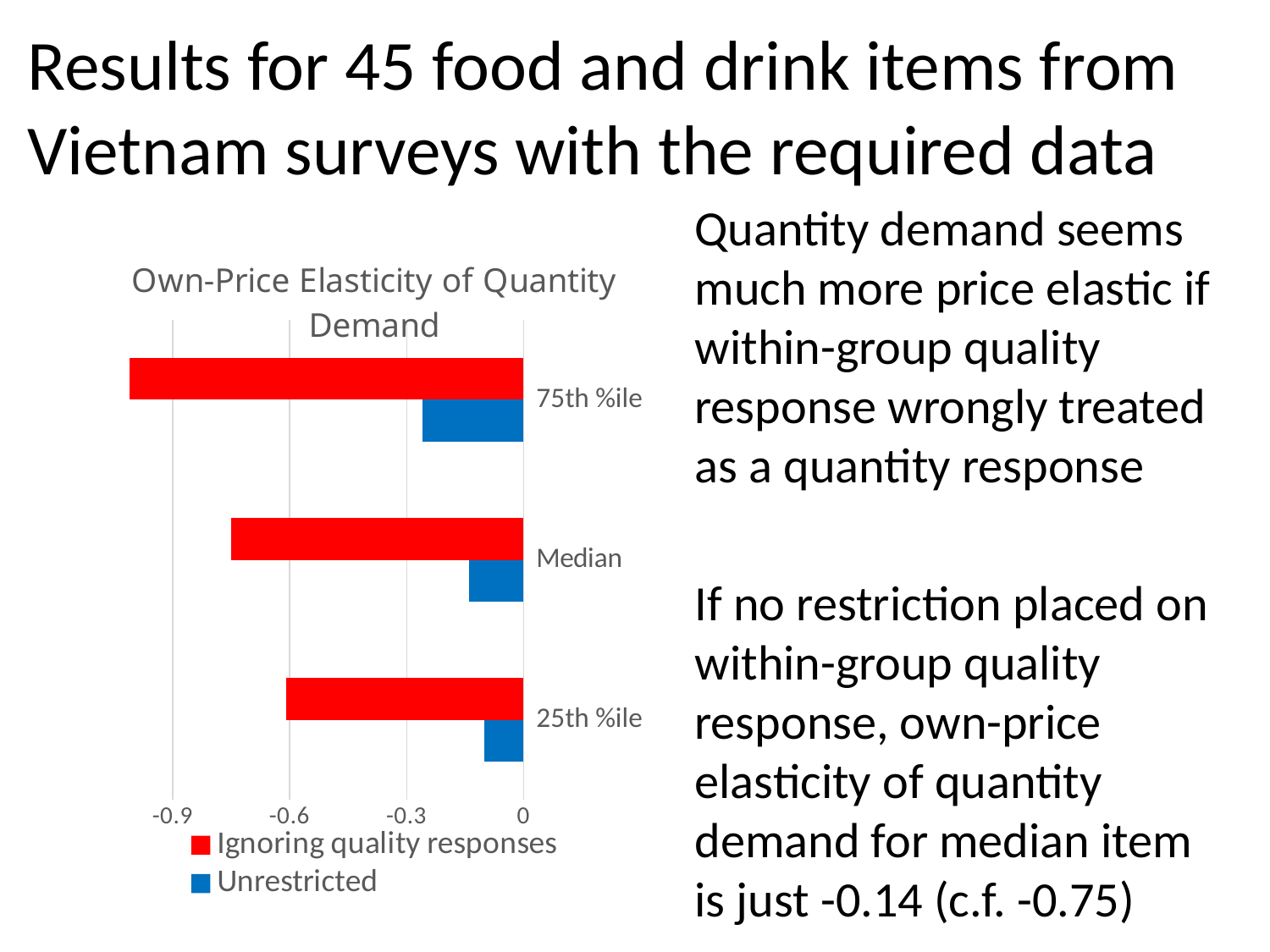
For the Median category, which series has the more negative elasticity, Ignoring quality responses or Unrestricted? Ignoring quality responses How many series does the chart legend list? 2 What kind of chart is shown on the slide? bar chart Is the Ignoring quality responses value for the 75th %ile greater or less than -0.9? less Is the Ignoring quality responses value for the Median greater or less than -0.6? less According to the slide, what is the Unrestricted own-price elasticity of quantity demand for the median item? -0.14 Is the Unrestricted value for the 75th %ile greater or less than -0.3? greater How many categories are plotted on the chart? 3 Which category has the value closest to zero for the Unrestricted series? 25th %ile Which series is shown in red? Ignoring quality responses Which category has the most negative value for the Ignoring quality responses series? 75th %ile What is the title of the chart? Own-Price Elasticity of Quantity Demand